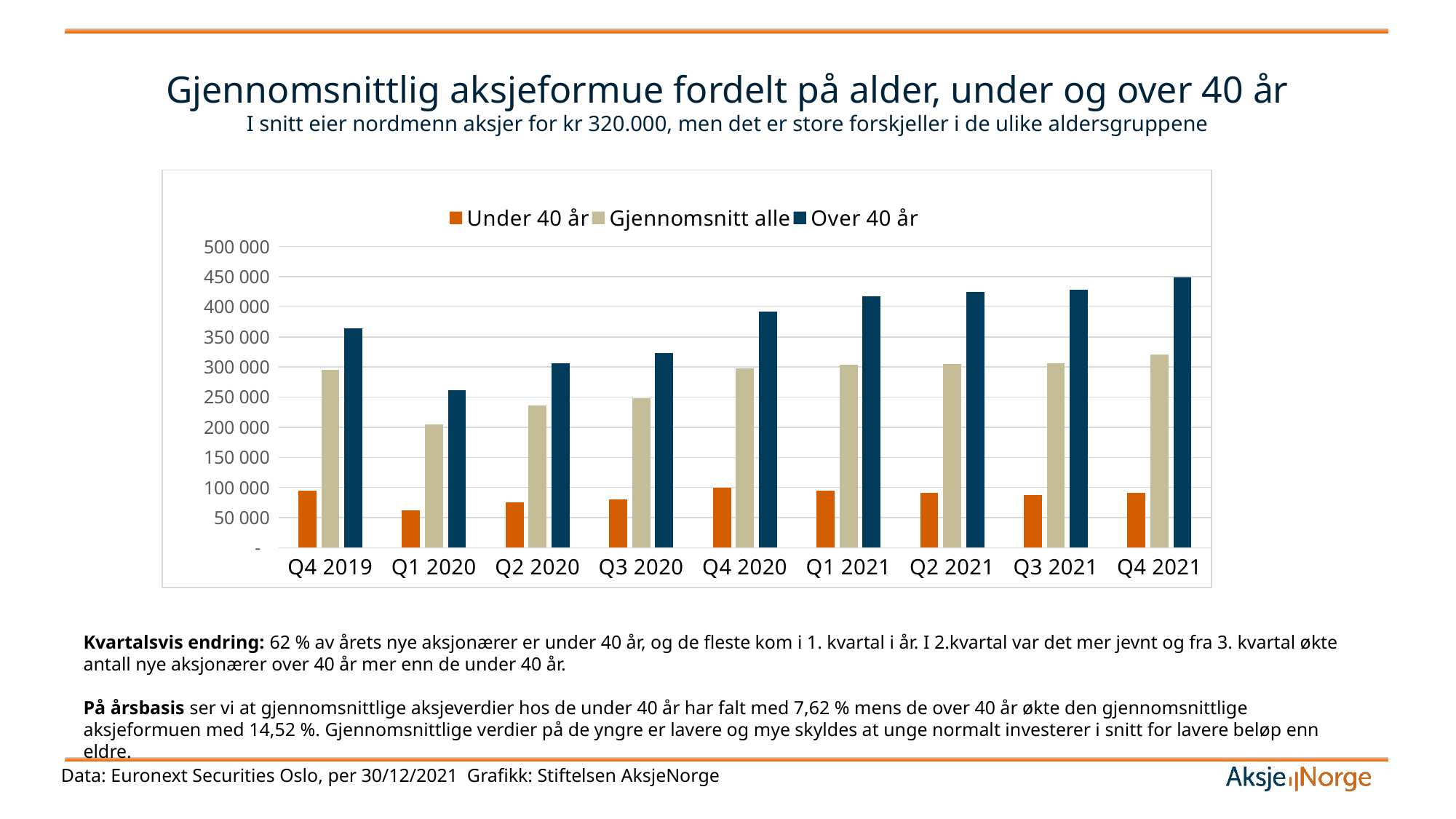
Do the values for Over 40 år rise or fall from Q1 2020 to Q4 2021? rise In which quarter is the value for Over 40 år highest? Q4 2021 How many quarters are shown on the x axis? 9 How many series does the legend list? 3 What kind of chart is shown on the slide? Bar chart In which quarter is the value for Over 40 år lowest? Q1 2020 What are the three series listed in the legend? Under 40 år, Gjennomsnitt alle, Over 40 år Is the value for Over 40 år in Q4 2021 greater or less than 400 000? greater In which quarter is the value for Under 40 år lowest? Q1 2020 Is the value for Gjennomsnitt alle in Q4 2021 greater or less than 300 000? greater Is the value for Gjennomsnitt alle in Q1 2020 greater or less than 250 000? less Which is larger for Over 40 år: the value in Q4 2019 or the value in Q4 2020? Q4 2020